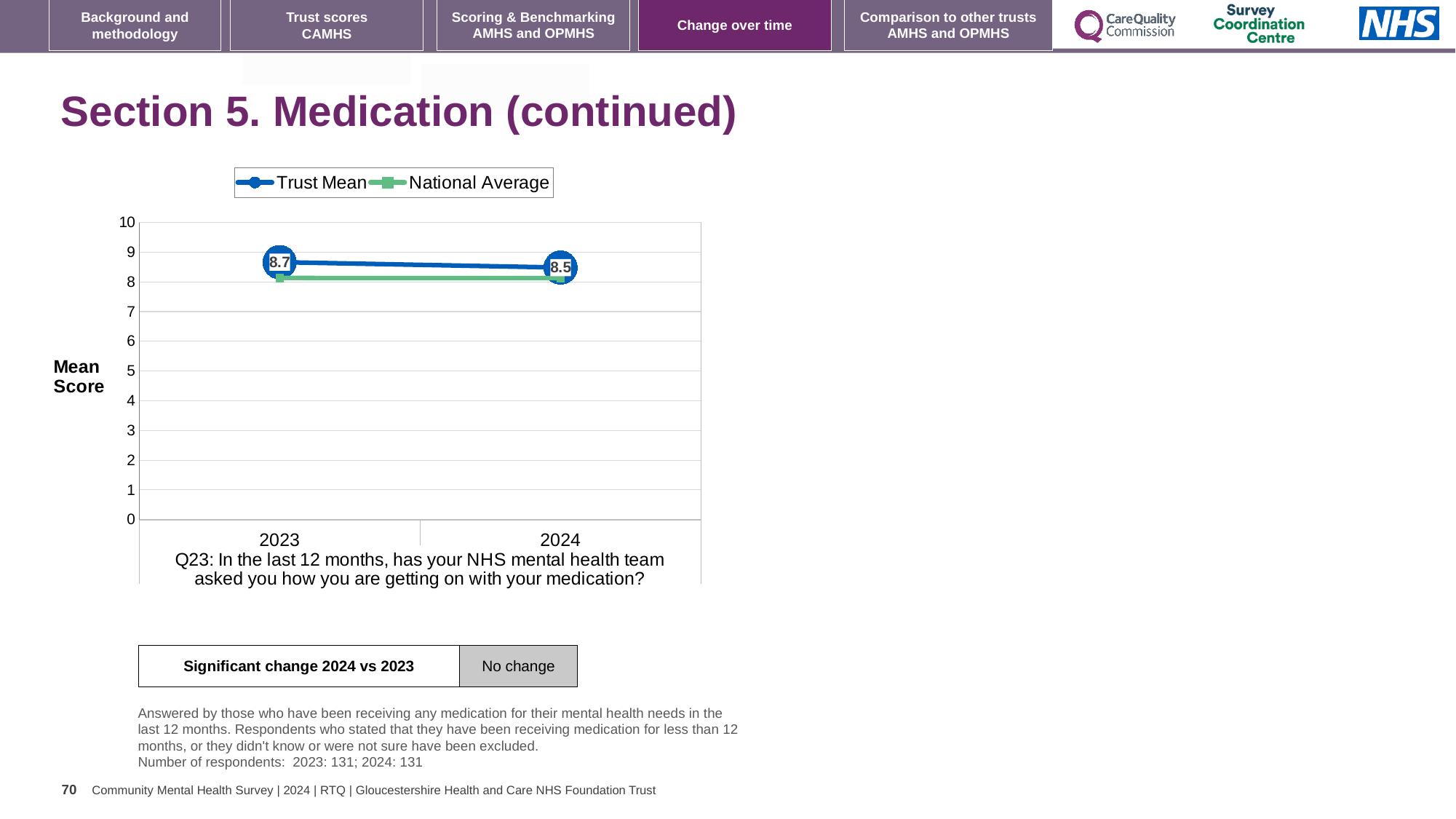
What kind of chart is shown on the slide? line chart What is the Trust Mean value for 2023? 8.7 By how much did the Trust Mean change from 2023 to 2024? 0.2 What is the label on the y axis of the chart? Mean Score Is the National Average value for 2023 greater or less than 7? greater How many series does the legend list? 2 What is the Trust Mean value for 2024? 8.5 How many years are shown on the x axis? 2 Is the National Average value for 2024 greater or less than 9? less In 2024, which is higher, the Trust Mean or the National Average? Trust Mean Does the Trust Mean rise or fall from 2023 to 2024? fall Which year has the higher Trust Mean, 2023 or 2024? 2023